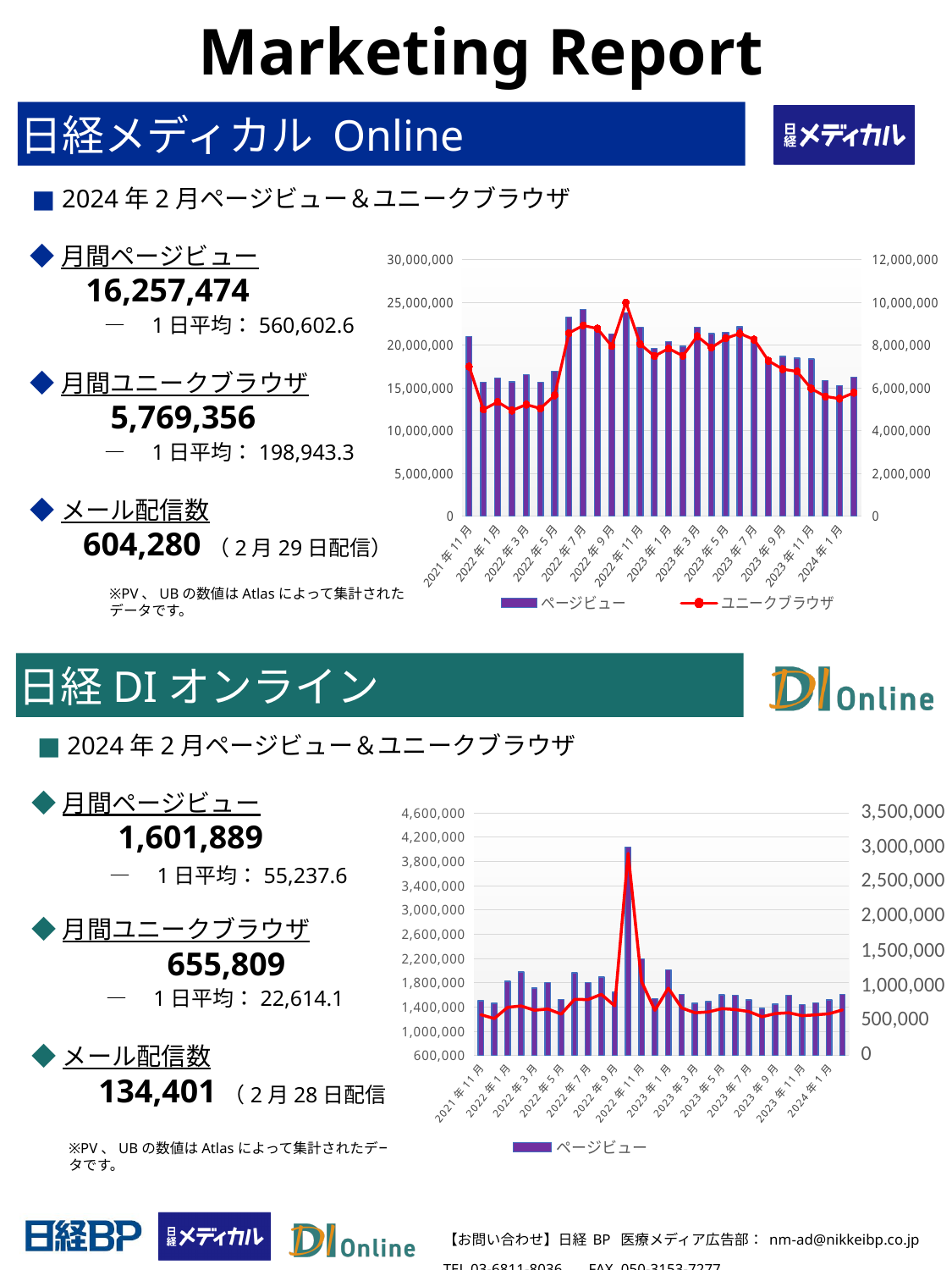
In the bottom chart (日経DIオンライン), is the highest page view bar greater or less than 3,800,000? greater What kind of chart is shown in the top section (日経メディカル Online)? A combined bar and line chart In the top chart (日経メディカル Online), is the page view bar for 2021年11月 greater or less than 15,000,000? greater In the top chart (日経メディカル Online), is the peak of the unique browser line greater or less than 8,000,000 on the right axis? greater How many series does the legend of the top chart (日経メディカル Online) list? 2 What is the maximum value shown on the left axis of the bottom chart (日経DIオンライン)? 4,600,000 In the top chart (日経メディカル Online), do the page view bars rise or fall from 2023年7月 to 2024年1月? fall In the top chart (日経メディカル Online), do the page view bars rise or fall from 2022年3月 to 2022年7月? rise What are the two legend entries of the top chart (日経メディカル Online)? ページビュー and ユニークブラウザ How many series does the legend of the bottom chart (日経DIオンライン) list? 1